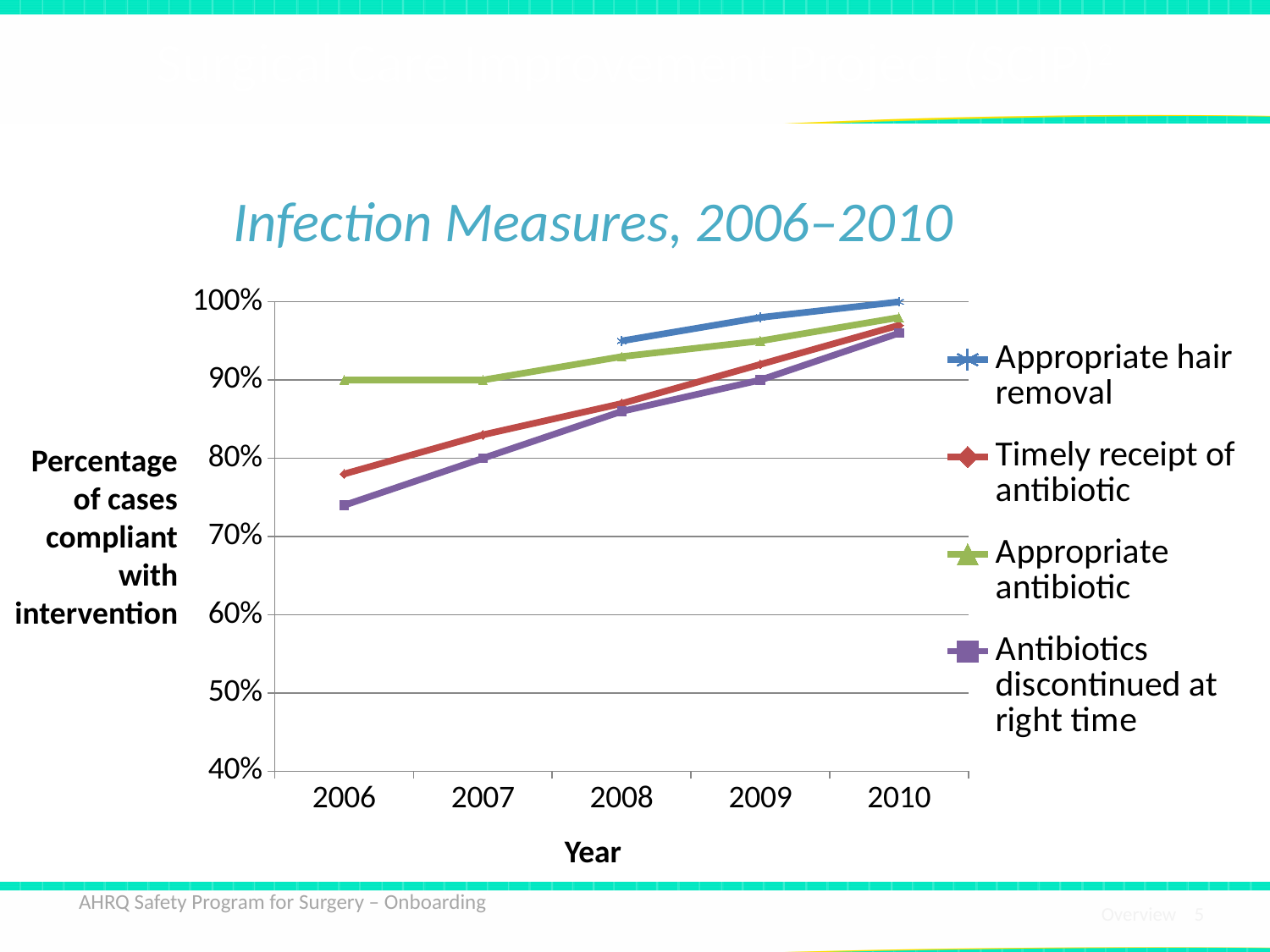
Which series has the highest value in 2010? Appropriate hair removal Which series has the lowest value in 2006? Antibiotics discontinued at right time Is the value for Timely receipt of antibiotic in 2006 greater or less than 80%? less In 2006, which is larger: Timely receipt of antibiotic or Antibiotics discontinued at right time? Timely receipt of antibiotic How many series does the legend list? 4 Do the values for Timely receipt of antibiotic rise or fall from 2006 to 2010? rise What is the title of the chart? Infection Measures, 2006–2010 What is the value for Appropriate hair removal in 2010? 100% What kind of chart is shown on the slide? line chart What is the value for Appropriate antibiotic in 2006? 90% How many years are shown on the x axis? 5 Is the value for Appropriate hair removal in 2008 greater or less than 90%? greater